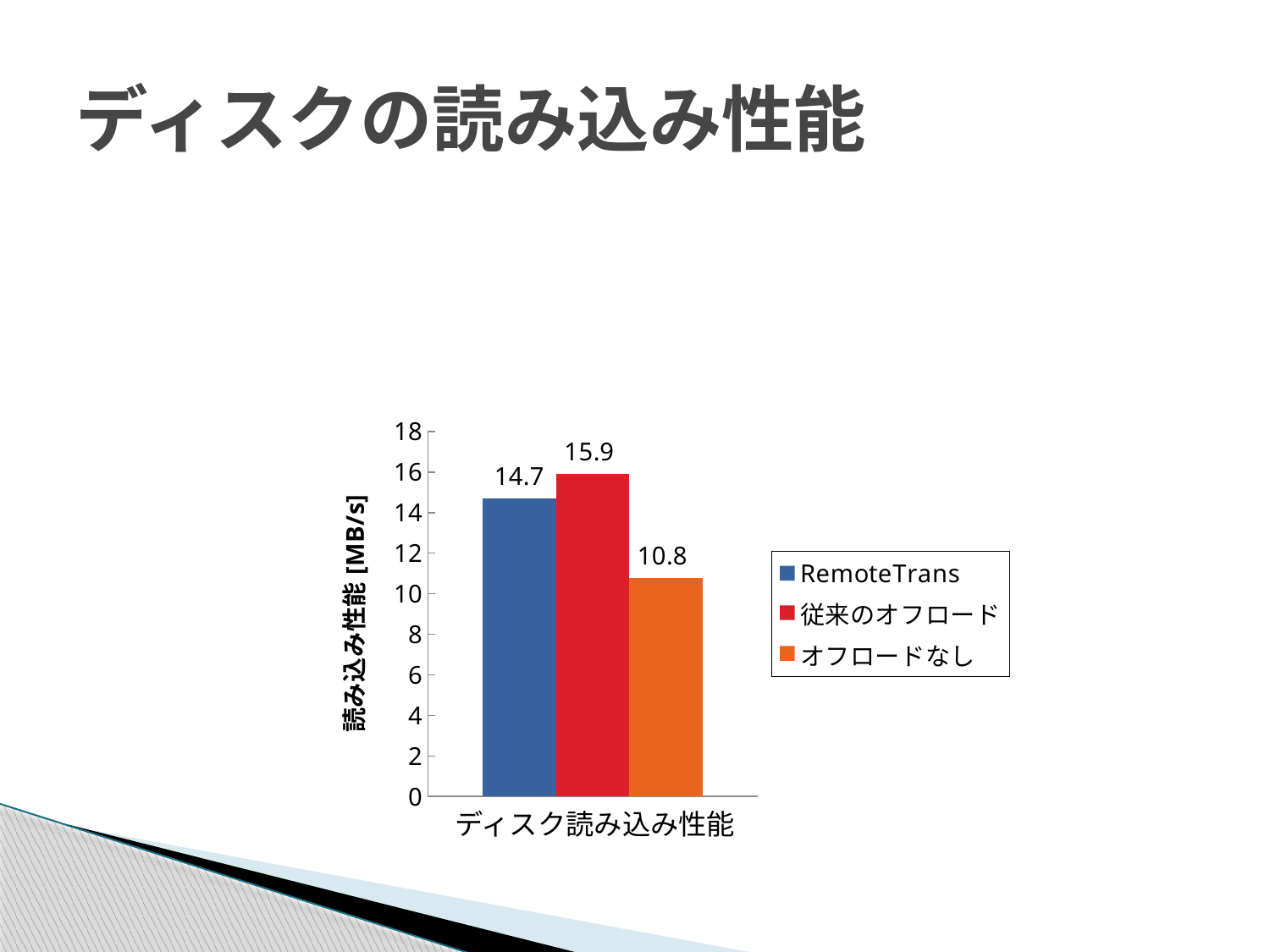
What is the y-axis label of the chart? 読み込み性能 [MB/s] Is the value for オフロードなし greater or less than 12? less What is the difference between the values for 従来のオフロード and RemoteTrans? 1.2 What is the disk read performance value for RemoteTrans? 14.7 Which is larger, the value for RemoteTrans or the value for オフロードなし? RemoteTrans What is the difference between the values for RemoteTrans and オフロードなし? 3.9 Which series has the lowest disk read performance? オフロードなし What kind of chart is shown on the slide? bar chart What is the disk read performance value for 従来のオフロード? 15.9 How many series does the legend list? 3 Which series has the highest disk read performance? 従来のオフロード What is the disk read performance value for オフロードなし? 10.8